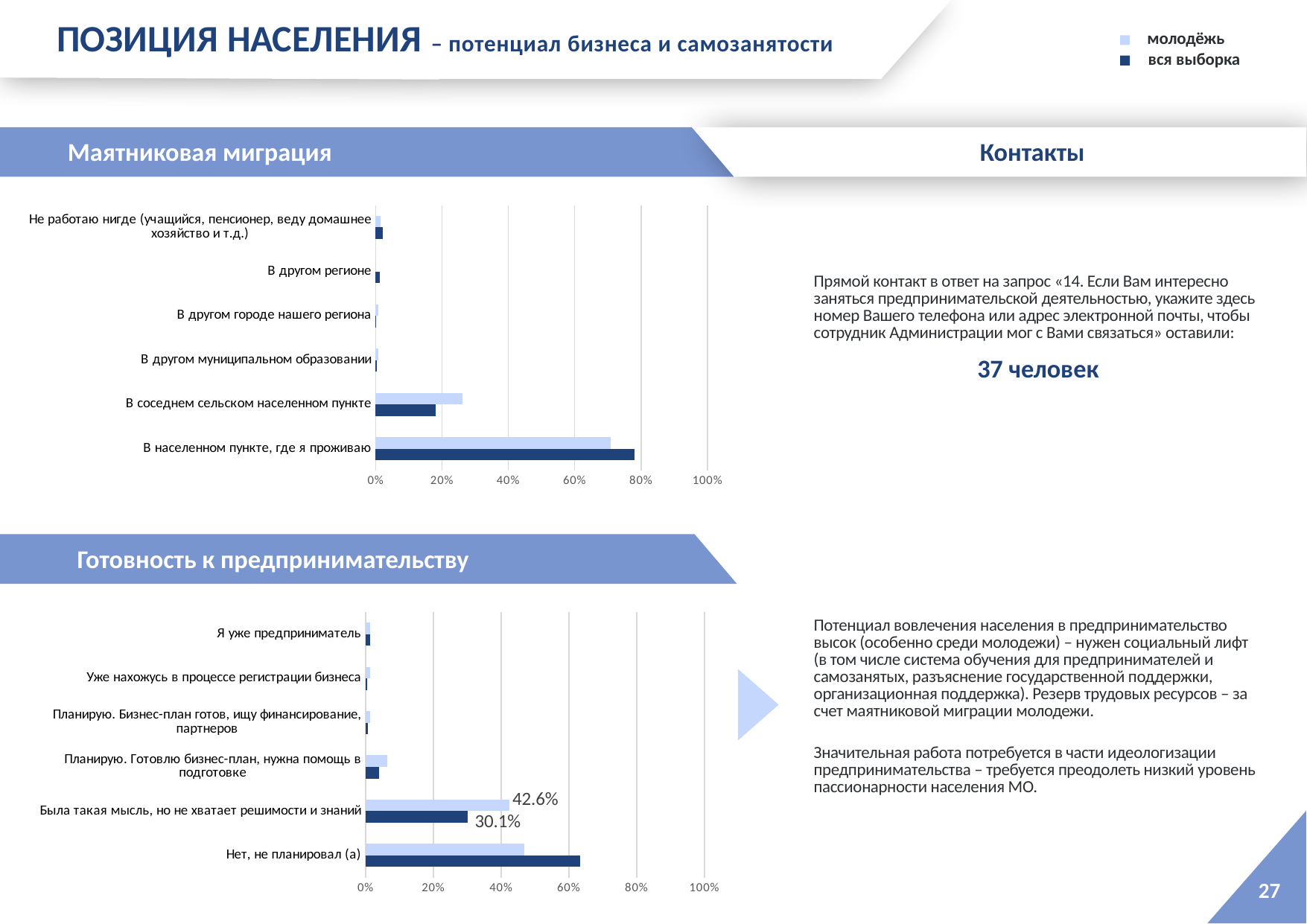
How many series does the legend list for the charts on this slide? 2 In the 'Готовность к предпринимательству' chart, for 'Нет, не планировал (а)', which series has the larger value: 'молодёжь' or 'вся выборка'? вся выборка What type of chart is the 'Маятниковая миграция' chart? Bar chart In the 'Маятниковая миграция' chart, for 'В соседнем сельском населенном пункте', which series has the larger value: 'молодёжь' or 'вся выборка'? молодёжь In the 'Готовность к предпринимательству' chart, what is the value for 'молодёжь' in the category 'Была такая мысль, но не хватает решимости и знаний'? 42.6% How many categories are shown in the 'Маятниковая миграция' chart? 6 In the 'Готовность к предпринимательству' chart, is the 'вся выборка' value for 'Нет, не планировал (а)' greater or less than 40%? greater In the 'Готовность к предпринимательству' chart, what is the difference between the 'молодёжь' and 'вся выборка' values for 'Была такая мысль, но не хватает решимости и знаний'? 12.5% In the 'Маятниковая миграция' chart, is the 'вся выборка' value for 'В населенном пункте, где я проживаю' greater or less than 60%? greater In the 'Маятниковая миграция' chart, which category has the highest value for 'вся выборка'? В населенном пункте, где я проживаю In the 'Готовность к предпринимательству' chart, what is the value for 'вся выборка' in the category 'Была такая мысль, но не хватает решимости и знаний'? 30.1% How many categories are shown in the 'Готовность к предпринимательству' chart? 6